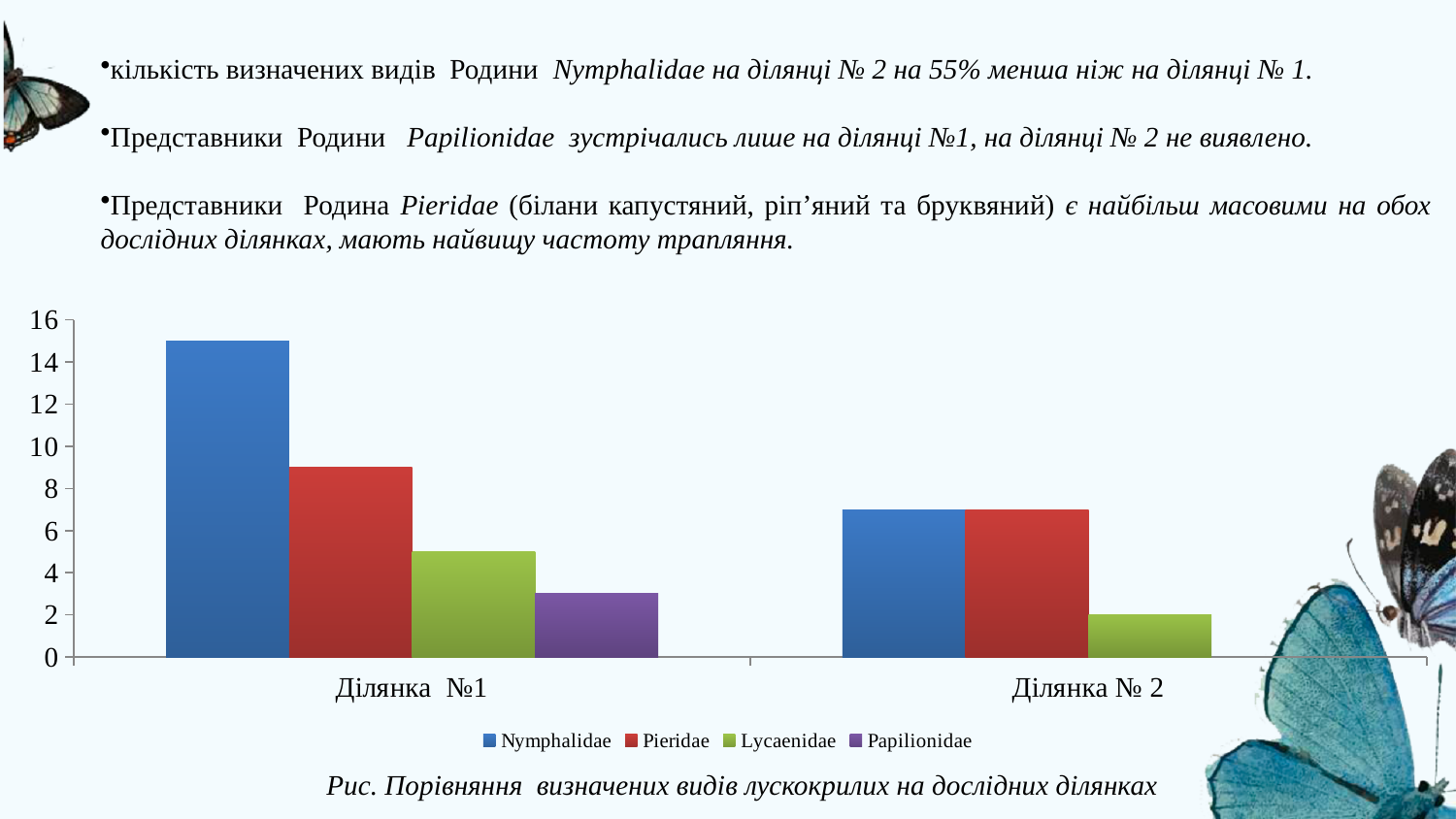
Is the value for Nymphalidae on Ділянка № 2 greater or less than 8? less What is the value for Lycaenidae on Ділянка № 2? 2 Is the value for Nymphalidae on Ділянка №1 greater or less than 14? greater Which is larger: the value for Nymphalidae on Ділянка №1 or on Ділянка № 2? Ділянка №1 Which series has the highest value on Ділянка №1? Nymphalidae Is the value for Papilionidae on Ділянка №1 greater or less than 4? less How many categories are shown on the x axis of the chart? 2 What kind of chart is shown on the slide? bar chart Which series is shown in red in the chart legend? Pieridae Which series has the lowest value on Ділянка №1? Papilionidae How many series does the chart legend list? 4